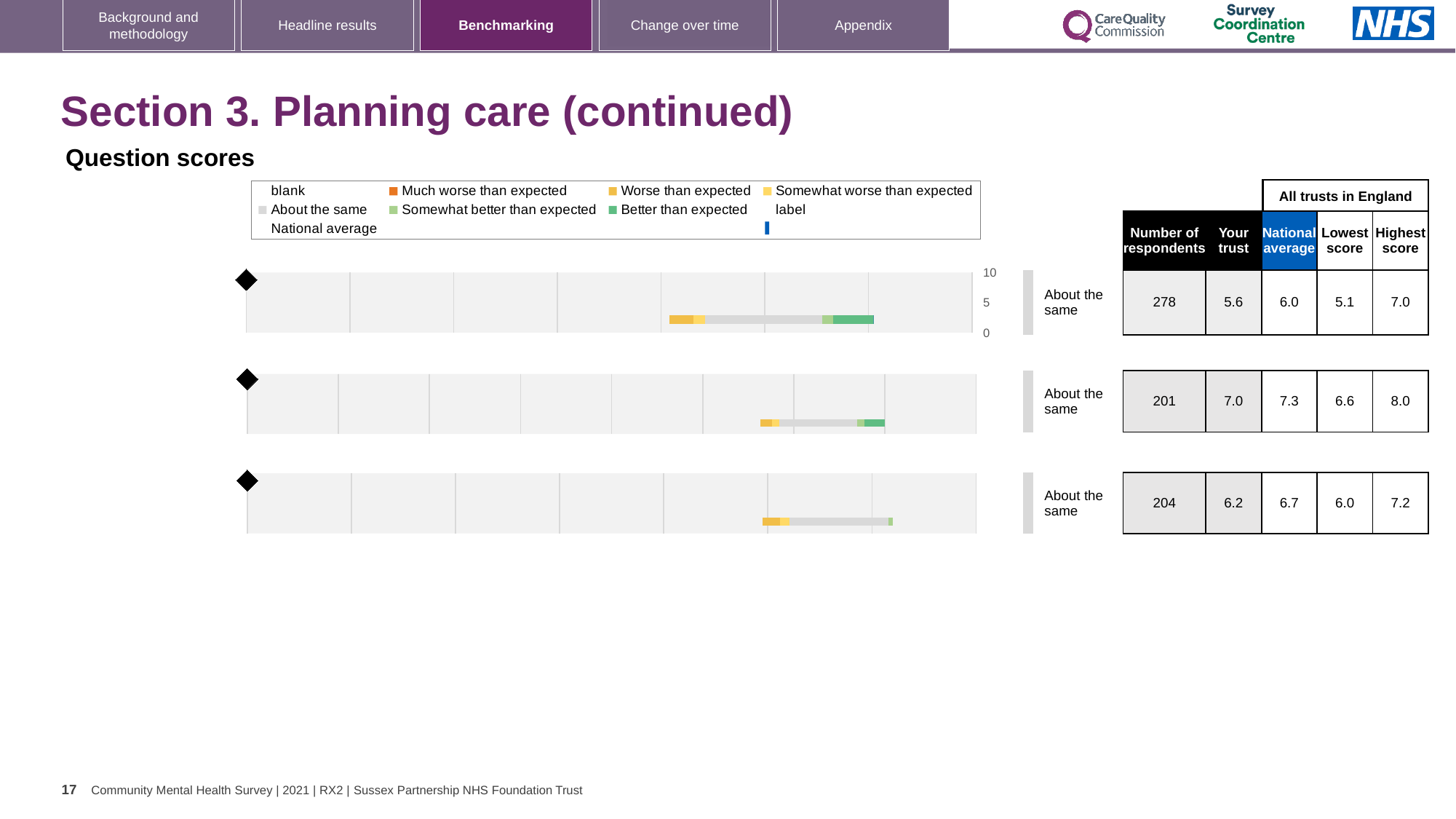
For the top chart, which is larger: the 'Your trust' score or the national average? National average For the top chart, what is the national average score? 6.0 For the top chart, what is the 'Your trust' score shown in the table? 5.6 For the bottom chart, what is the highest score among all trusts in England? 7.2 For the middle chart, how many respondents are listed? 201 How many question score charts are shown on the slide? 3 Which chart has the largest number of respondents: top, middle or bottom? top What kind of chart is used for the question scores on this slide? bar chart For the middle chart, what is the difference between the highest score and the lowest score? 1.4 What benchmark category is shown next to the middle chart? About the same In the legend, what colour represents 'Better than expected'? green For the bottom chart, what is the difference between the national average and the 'Your trust' score? 0.5